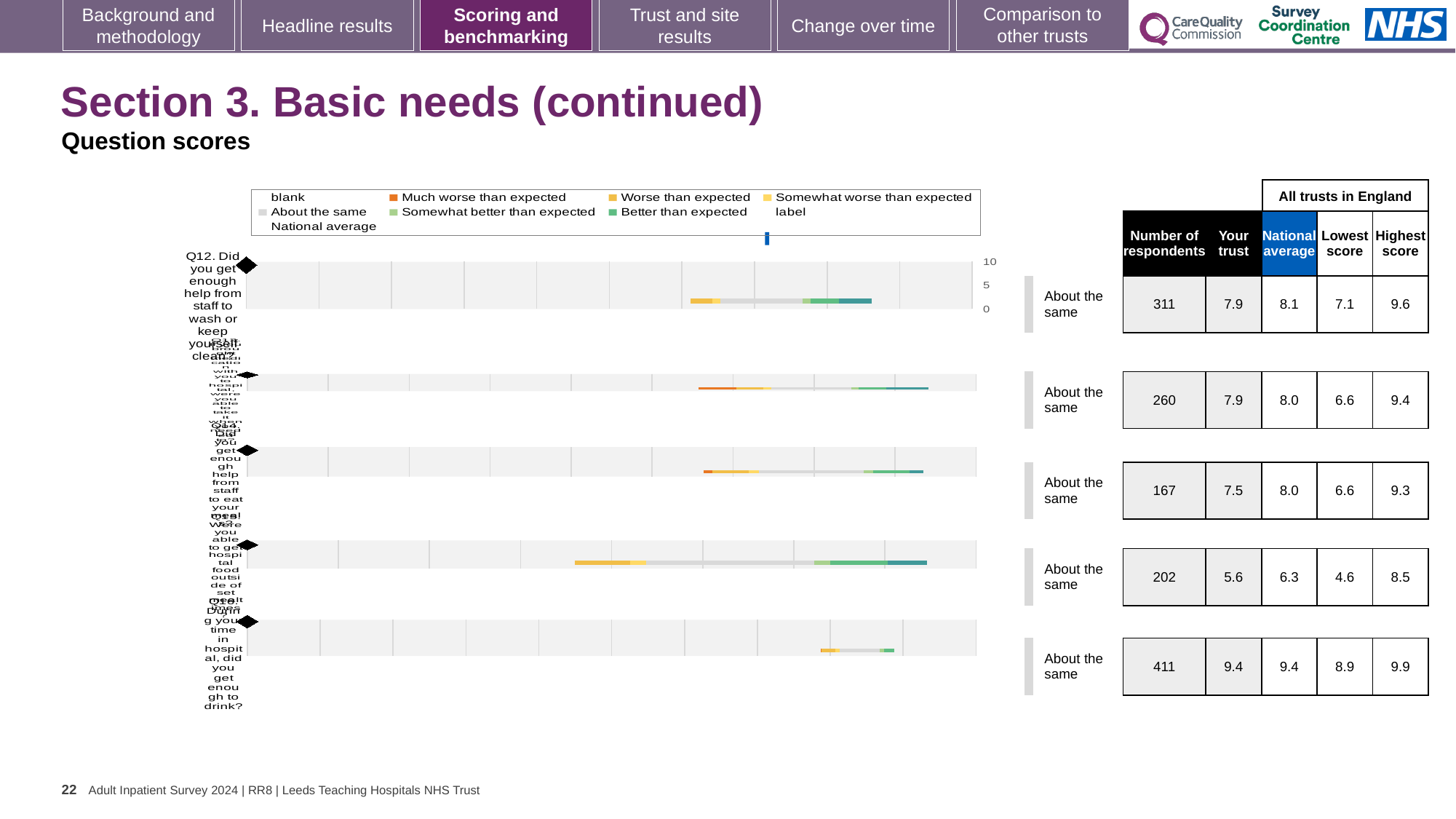
What is the 'Your trust' score for Q16 (did you get enough to drink)? 9.4 How many entries does the chart legend list? 9 What is the 'Your trust' score for Q12 (help from staff to wash or keep yourself clean)? 7.9 What benchmark category is shown for Q12? About the same What is the number of respondents for Q12 (help from staff to wash or keep yourself clean)? 311 How many question rows are plotted in the chart? 5 What kind of chart is used to show the question scores on this slide? bar chart What is the national average for Q14 (help from staff to eat your meals)? 8.0 For Q12, which is larger: the 'Your trust' score or the national average? National average What is the lowest 'Your trust' score shown in the table? 5.6 Which question has the highest number of respondents? Q16 (did you get enough to drink) What is the difference between the highest score and the lowest score for Q12? 2.5